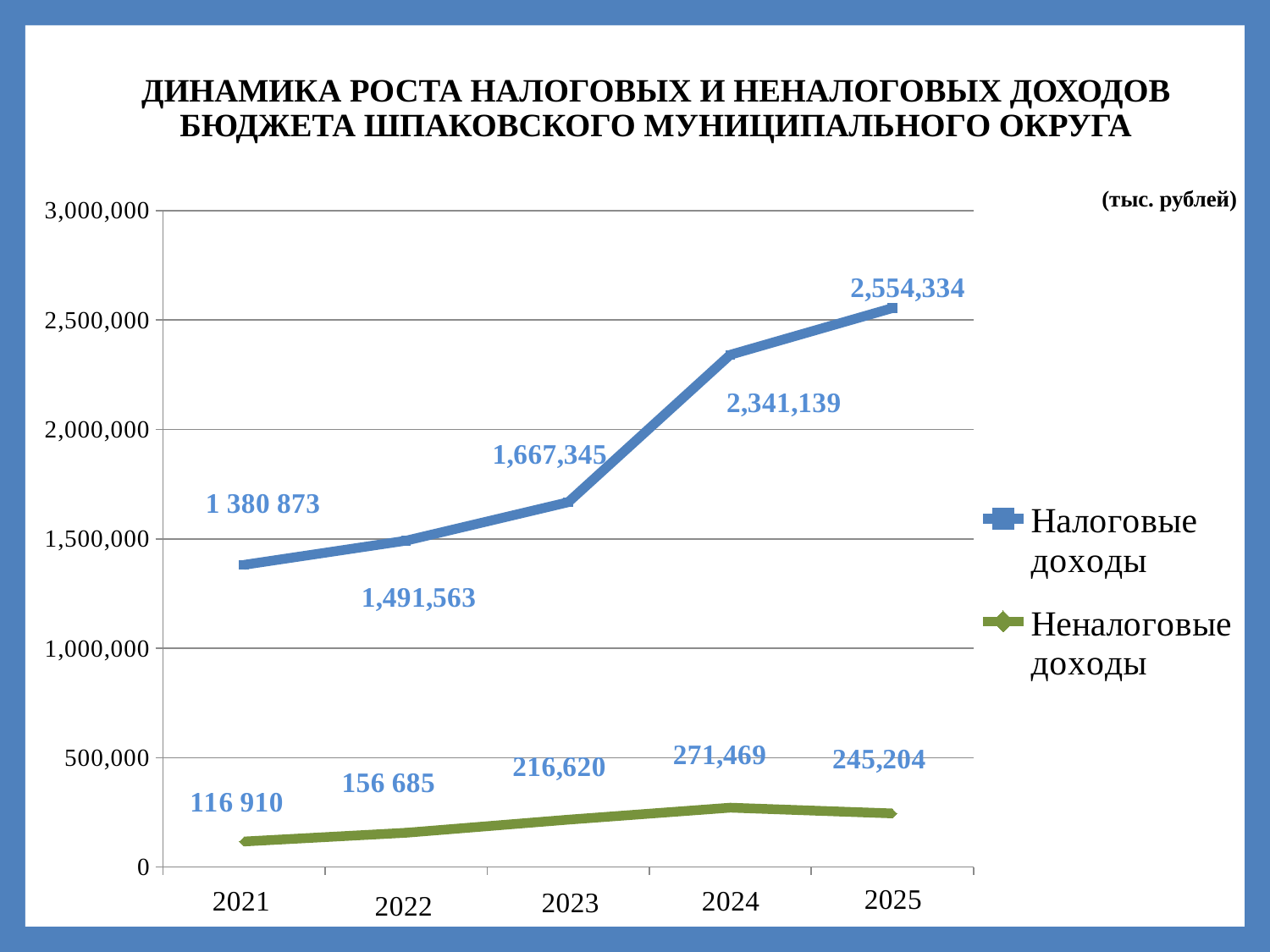
In which year are Налоговые доходы lowest? 2021 What is the value of Налоговые доходы in 2021? 1 380 873 Which is larger: Неналоговые доходы in 2024 or in 2025? 2024 What type of chart is shown on the slide? Line chart How many years are plotted along the x axis? 5 What is the difference between Налоговые доходы in 2025 and in 2024? 213,195 What unit is indicated for the values on the chart? тыс. рублей In which year are Неналоговые доходы highest? 2024 Do Налоговые доходы rise or fall from 2021 to 2025? Rise How many series does the legend list? 2 What is the value of Налоговые доходы in 2025? 2,554,334 What is the value of Неналоговые доходы in 2023? 216,620